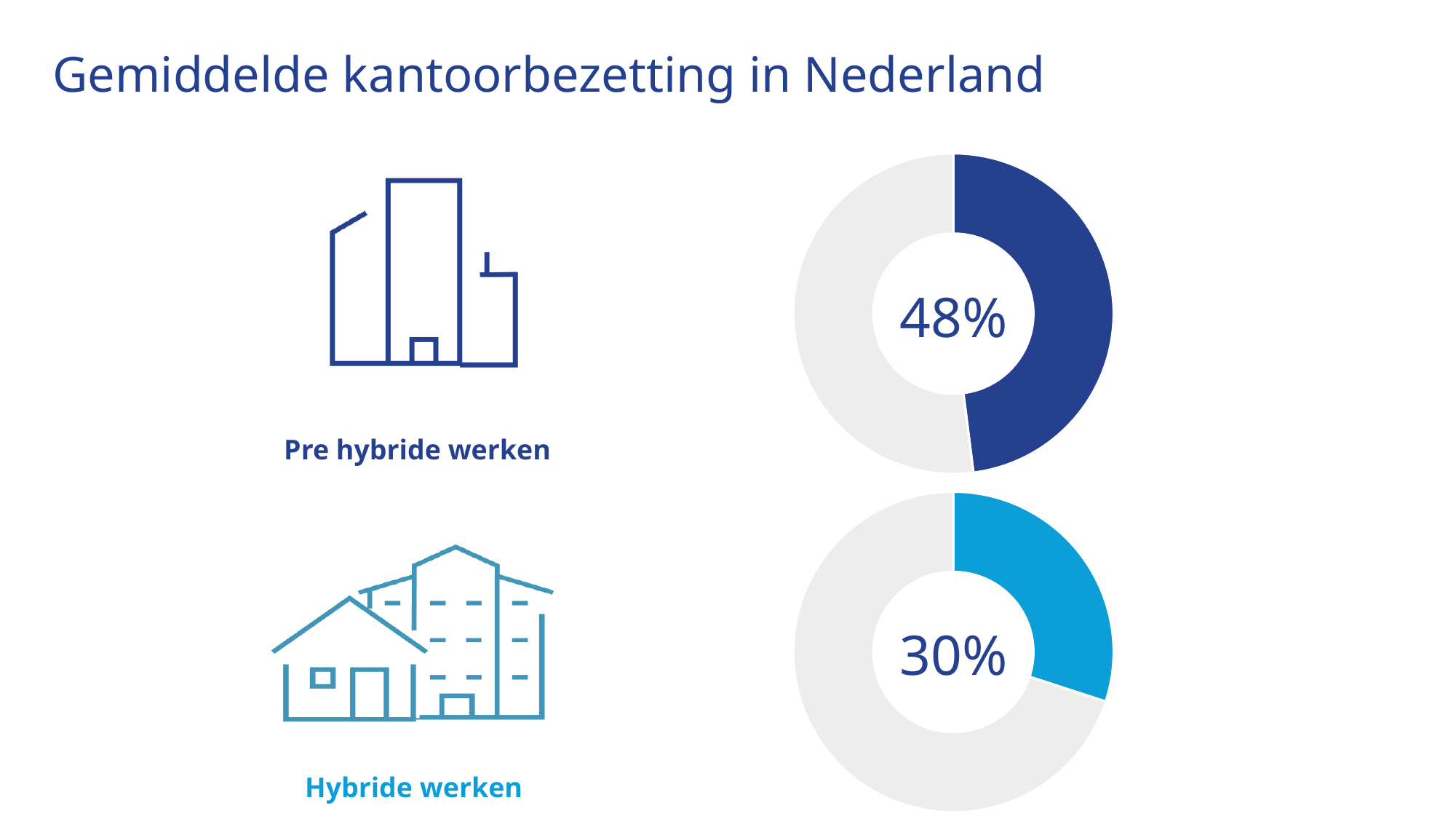
On the top donut chart (Pre hybride werken), is the coloured share greater or less than 50%? less On the bottom donut chart (Hybride werken), is the coloured share greater or less than 25%? greater On the top donut chart (Pre hybride werken), what share of the donut is left uncoloured (grey)? 52% What is the title of the slide containing the two donut charts? Gemiddelde kantoorbezetting in Nederland What is the difference between the value on the top donut chart (Pre hybride werken) and the value on the bottom donut chart (Hybride werken)? 18% Which of the two donut charts shows the lower value, the top one (Pre hybride werken) or the bottom one (Hybride werken)? Hybride werken On the bottom donut chart (Hybride werken), what percentage is shown in the centre? 30% On the top donut chart (Pre hybride werken), what percentage is shown in the centre? 48% What kind of chart is used to show the 48% value for Pre hybride werken? Donut chart How many donut charts are shown on the slide? 2 What colour is the filled segment of the bottom donut chart (Hybride werken)? Light blue Which of the two donut charts shows the higher value, the top one (Pre hybride werken) or the bottom one (Hybride werken)? Pre hybride werken